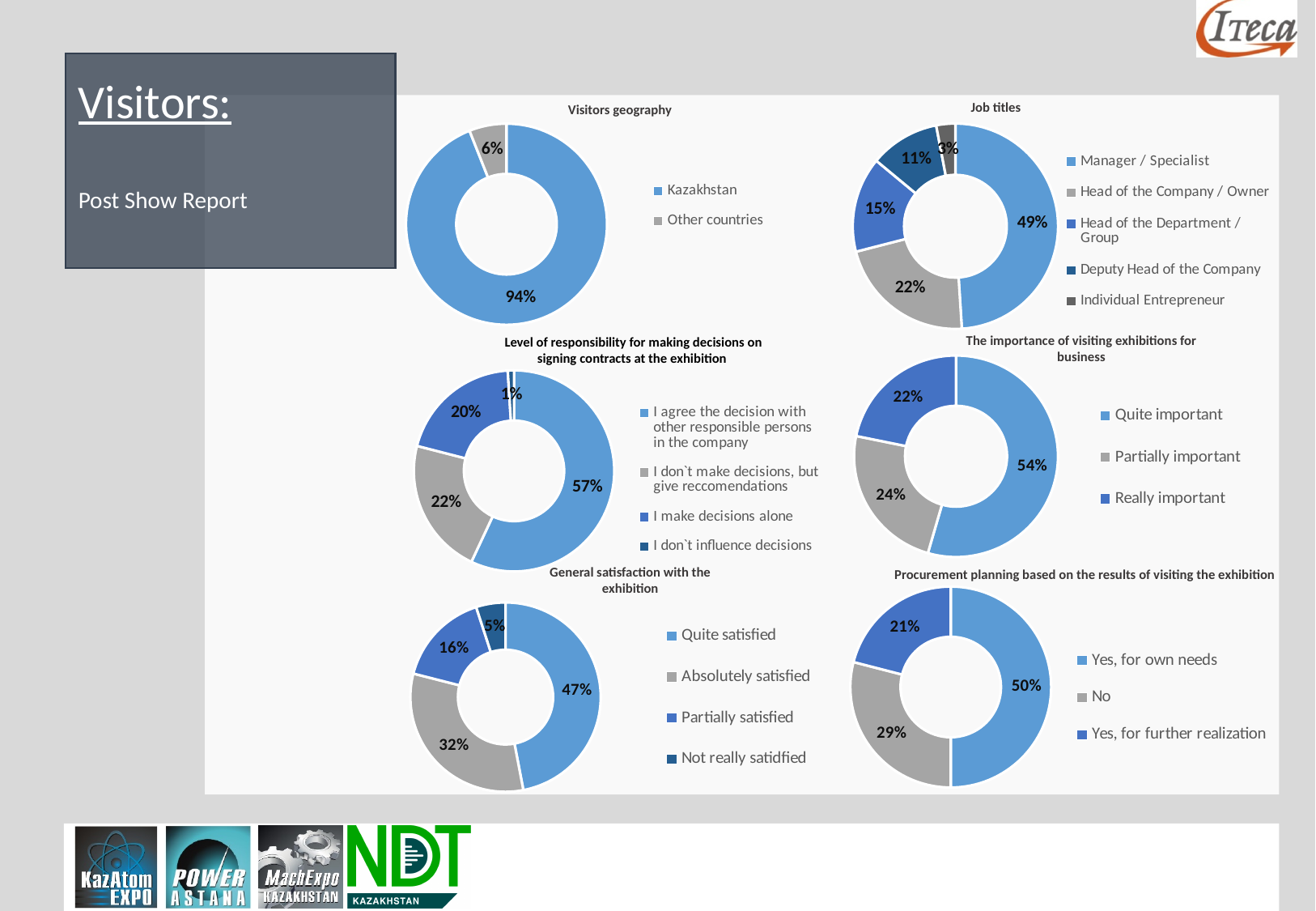
In the 'Level of responsibility for making decisions on signing contracts at the exhibition' chart, what share of visitors agree the decision with other responsible persons in the company? 57% In the 'General satisfaction with the exhibition' chart, what is the combined share of 'Quite satisfied' and 'Absolutely satisfied'? 79% In 'The importance of visiting exhibitions for business' chart, what share of visitors said 'Really important'? 22% In the 'Job titles' chart, what percentage of visitors are Manager / Specialist? 49% In the 'Procurement planning based on the results of visiting the exhibition' chart, what share answered 'No'? 29% In the 'Job titles' chart, what is the difference between the share of Head of the Company / Owner and Head of the Department / Group? 7% In the 'Job titles' chart, which job title has the smallest share? Individual Entrepreneur In the 'Visitors geography' chart, what share of visitors came from other countries? 6% In the 'Visitors geography' chart, what share of visitors came from Kazakhstan? 94% In the 'Level of responsibility for making decisions on signing contracts at the exhibition' chart, which is larger: the share who don't make decisions but give recommendations, or the share who make decisions alone? I don`t make decisions, but give reccomendations How many categories does the legend of the 'Job titles' chart list? 5 What type of chart is used for 'Procurement planning based on the results of visiting the exhibition'? Doughnut chart